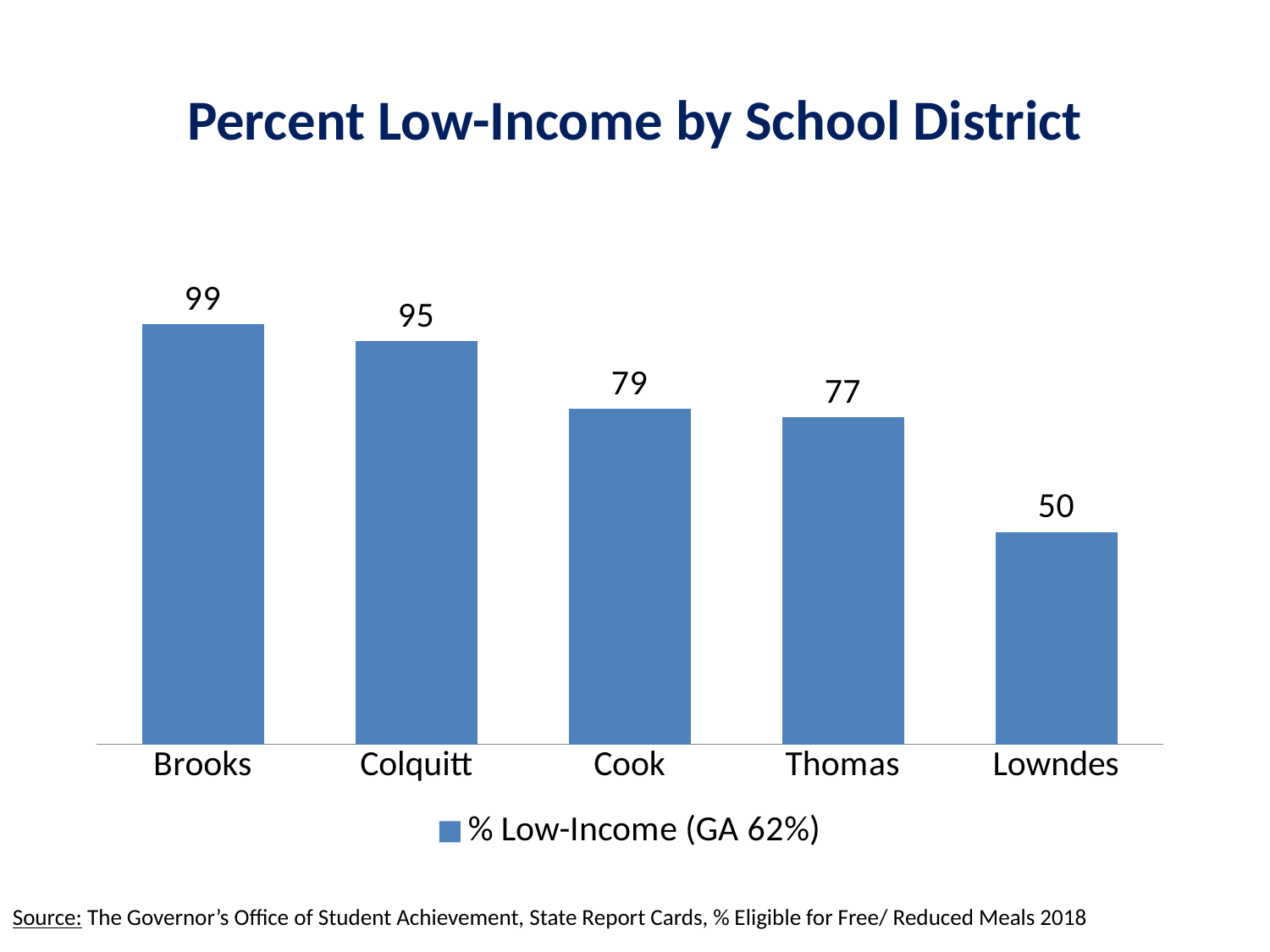
What is the percent low-income value for Brooks? 99 Which school district has the highest percent low-income? Brooks What is the percent low-income value for Cook? 79 Which school district has the lowest percent low-income? Lowndes What is the difference between the values for Brooks and Lowndes? 49 What is the legend entry for the series in the chart? % Low-Income (GA 62%) Which has a higher percent low-income, Cook or Thomas? Cook What is the percent low-income value for Lowndes? 50 What kind of chart is shown on the slide? Bar chart How many school districts are shown in the chart? 5 What is the difference between the values for Colquitt and Thomas? 18 Do the values rise or fall from left to right across the districts? Fall